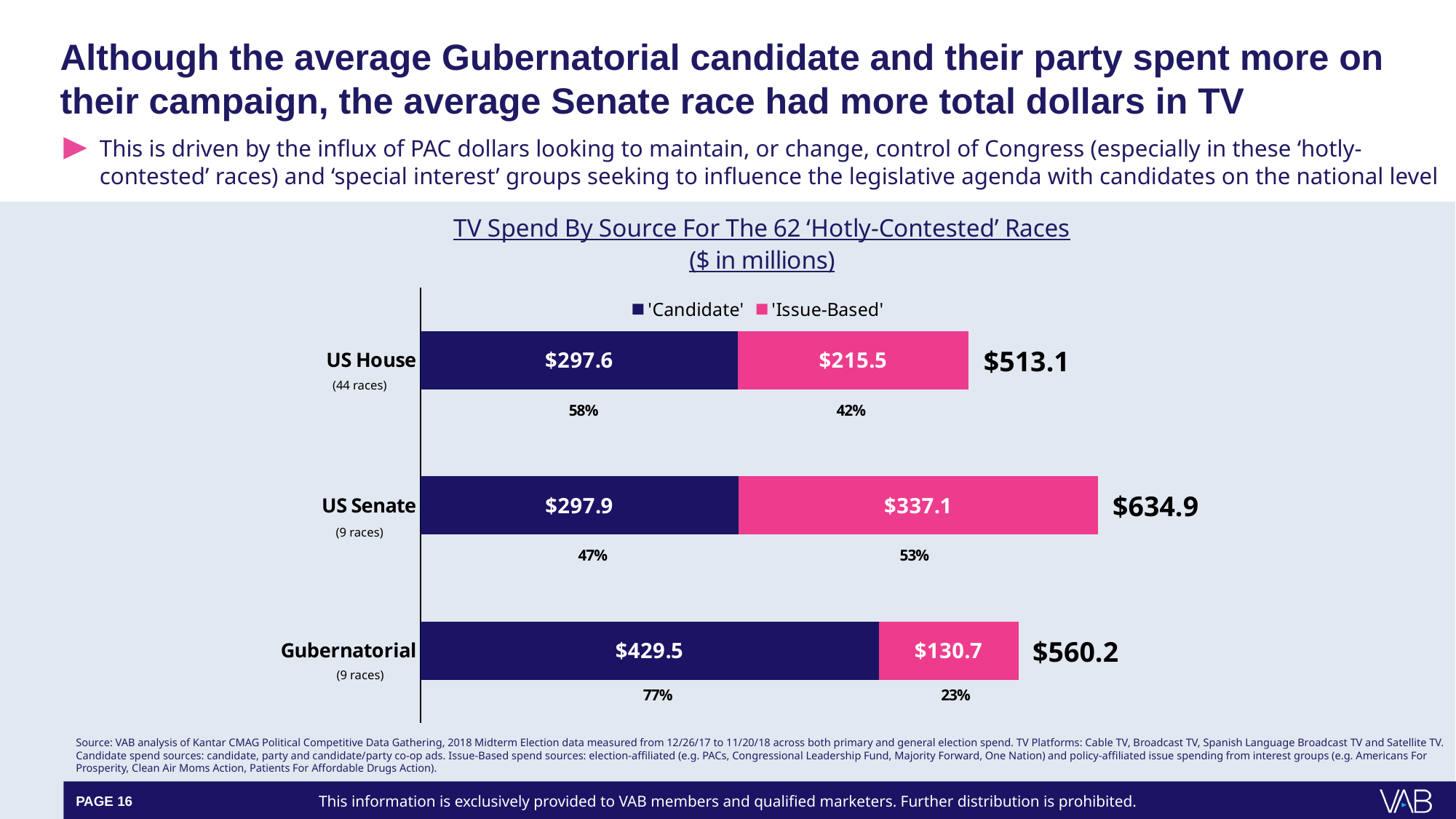
Which race type has the highest total TV spend? US Senate What is the total TV spend for Gubernatorial races? $560.2 What is the 'Issue-Based' TV spend for US Senate? $337.1 Which race type has the lowest 'Issue-Based' TV spend? Gubernatorial Which is larger for US Senate: 'Candidate' spend or 'Issue-Based' spend? 'Issue-Based' How many race types are shown in the chart? 3 What is the 'Candidate' TV spend for US House? $297.6 What is the difference between the 'Candidate' spend for Gubernatorial and US Senate races? $131.6 What kind of chart is shown on the slide? Stacked bar chart What is the 'Issue-Based' TV spend for Gubernatorial races? $130.7 What share of US House TV spend is 'Issue-Based'? 42% How many series does the legend list? 2